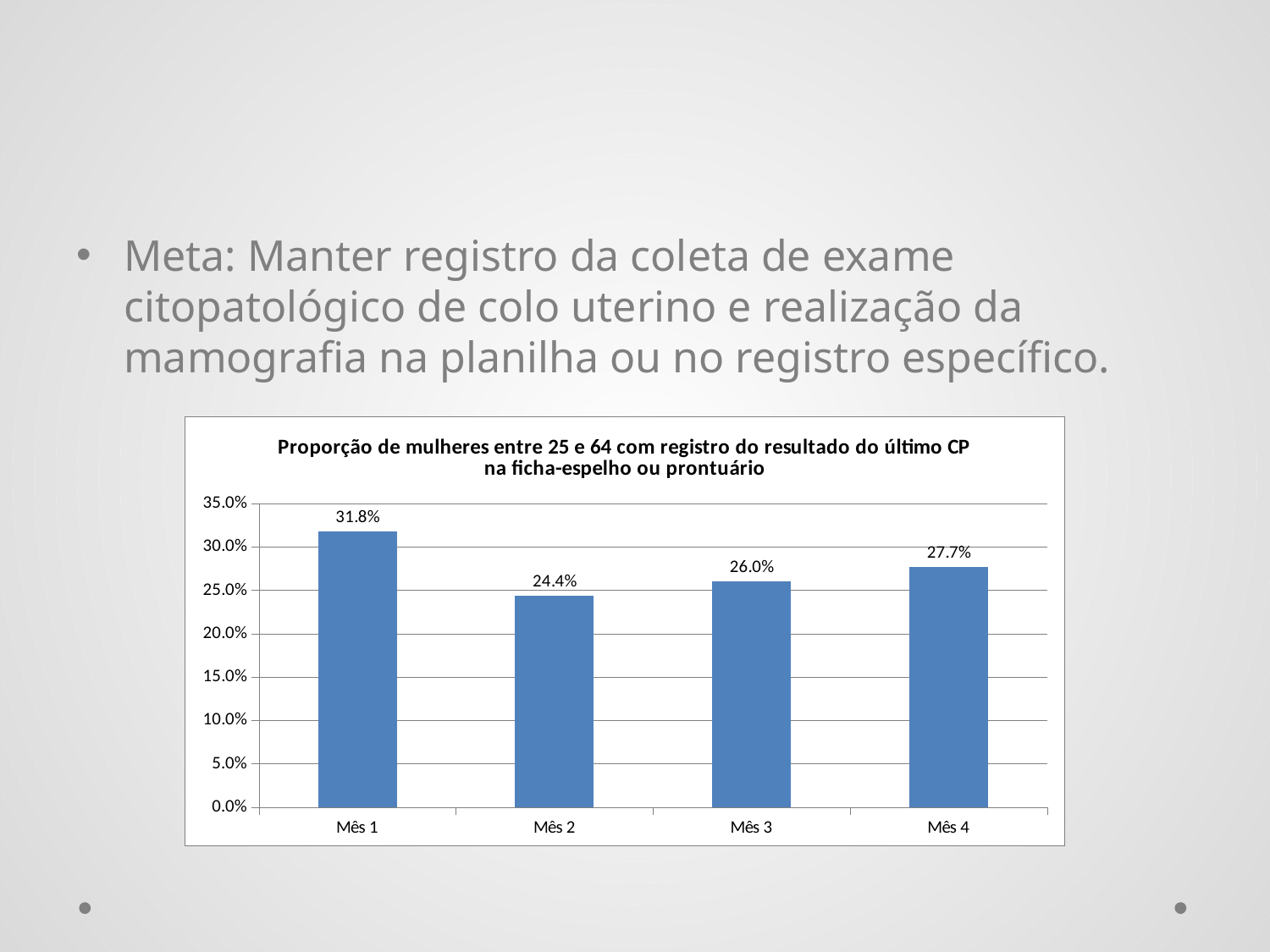
What kind of chart is shown on the slide? Bar chart Do the values rise or fall from Mês 2 to Mês 4? Rise How many months are shown on the x axis? 4 What is the value for Mês 3? 26.0% What is the value for Mês 1? 31.8% Which is larger, the value for Mês 3 or the value for Mês 4? Mês 4 What is the value for Mês 4? 27.7% Is the value for Mês 1 greater or less than 30.0%? greater What is the difference between the values for Mês 1 and Mês 2? 7.4% Which month has the lowest value? Mês 2 What is the value for Mês 2? 24.4% Which month has the highest value? Mês 1